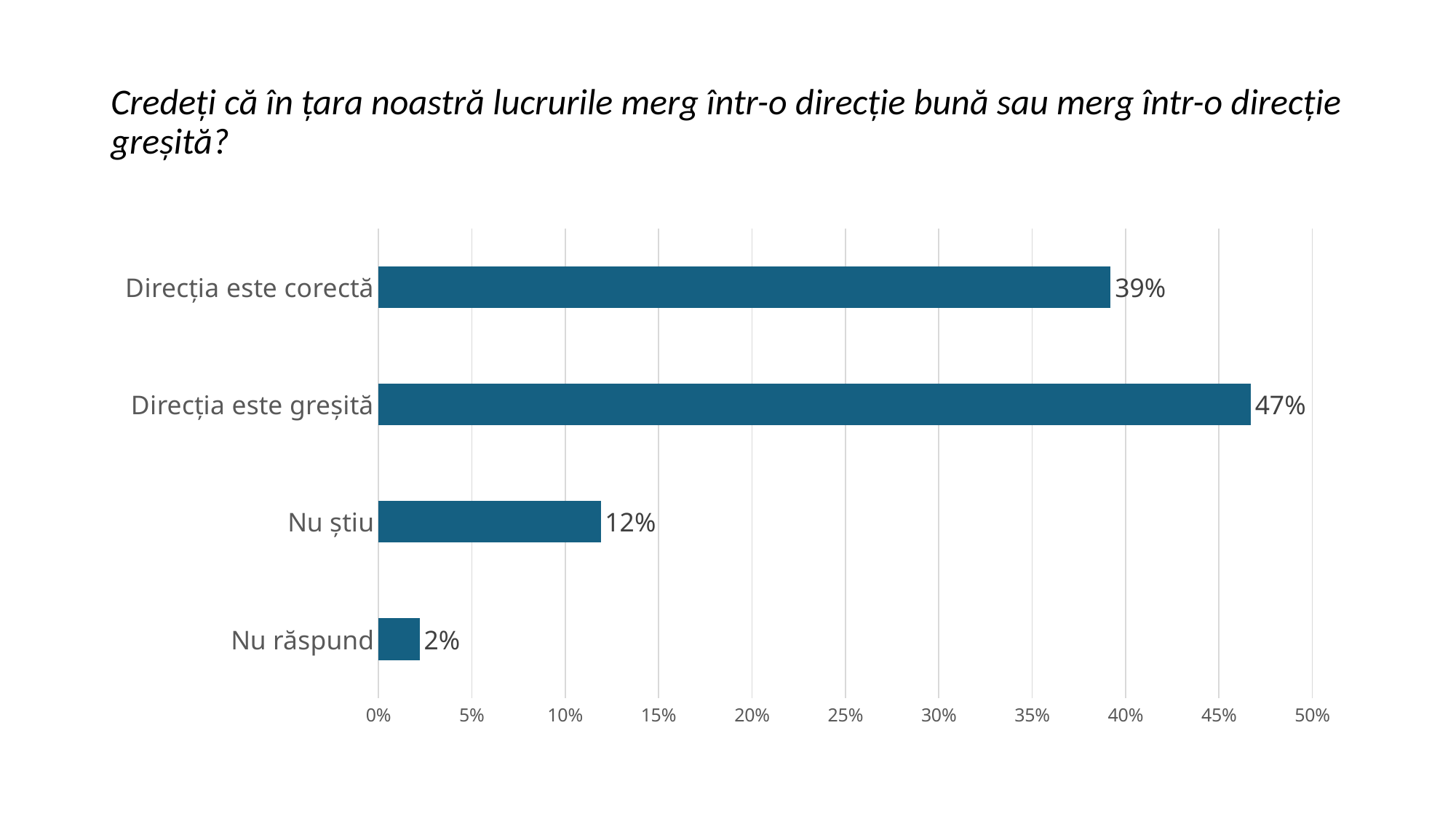
How many categories are shown in the chart? 4 Is the value for "Direcția este corectă" greater or less than 40%? less What is the value shown for "Direcția este greșită"? 47% What is the maximum value shown on the horizontal axis? 50% What is the value for "Nu răspund"? 2% Which is larger: "Nu știu" or "Nu răspund"? Nu știu Which category has the lowest value? Nu răspund What kind of chart is shown on the slide? Bar chart Which category has the highest value? Direcția este greșită What percentage is shown for "Nu știu"? 12% What is the difference between "Direcția este greșită" and "Direcția este corectă"? 8% What percentage of respondents answered "Direcția este corectă"? 39%